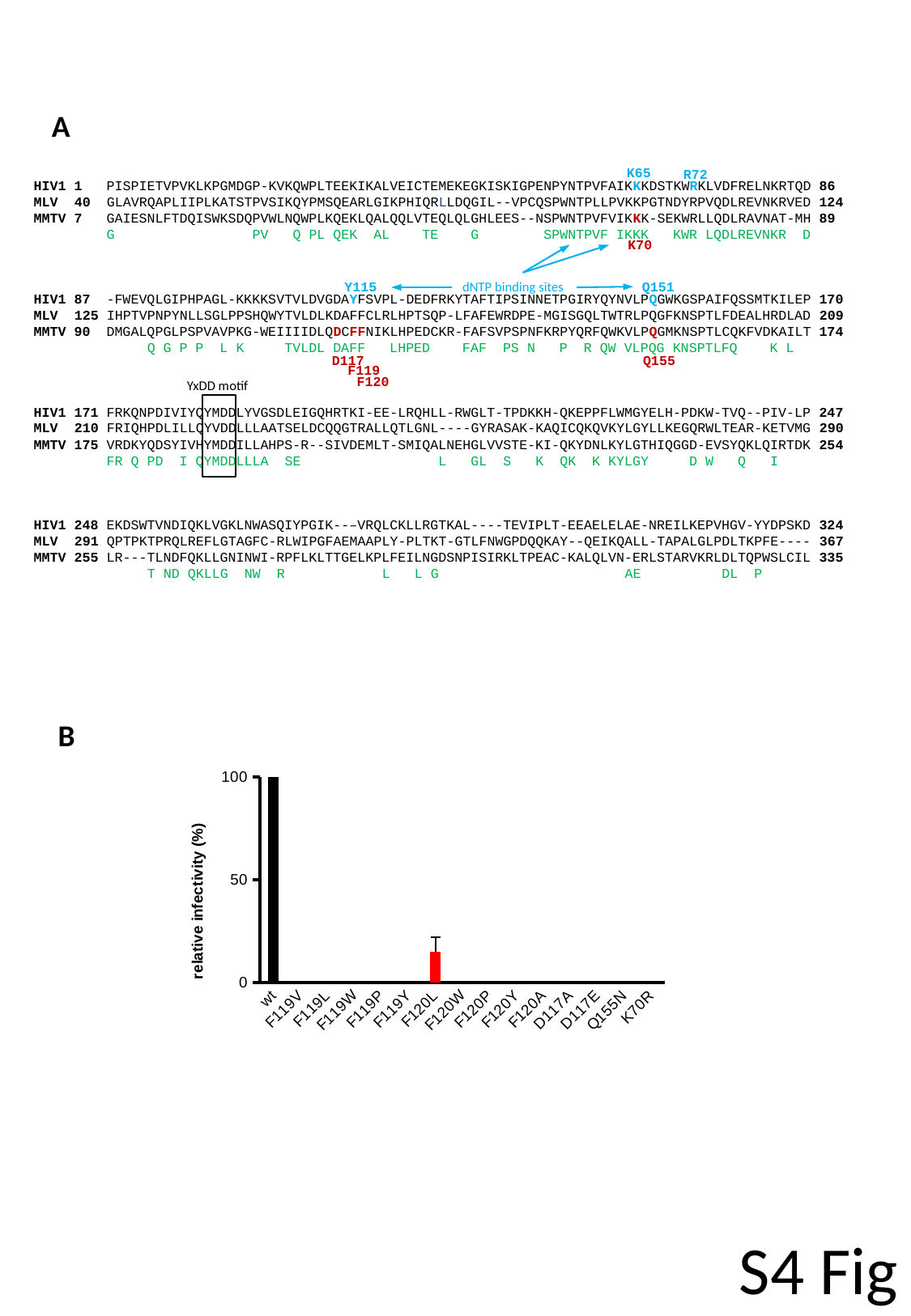
In the panel B chart, which is larger, the value for wt or the value for F120L? wt In the panel B chart, what is the last category on the x axis? K70R In the panel B chart, how many categories are shown on the x axis? 15 What is the y-axis label of the panel B chart? relative infectivity (%) In the panel B chart, which is larger, the value for F120L or the value for F119V? F120L In the panel B chart, which category has the highest relative infectivity? wt In the panel B chart, is the value for wt greater or less than 50? greater In the panel B chart, what colour is the bar for F120L? red In the panel B chart, what is the first category on the x axis? wt What kind of chart is shown in panel B? bar chart In the panel B chart, what is the relative infectivity (%) for wt? 100 In the panel B chart, is the value for F120L greater or less than 50? less